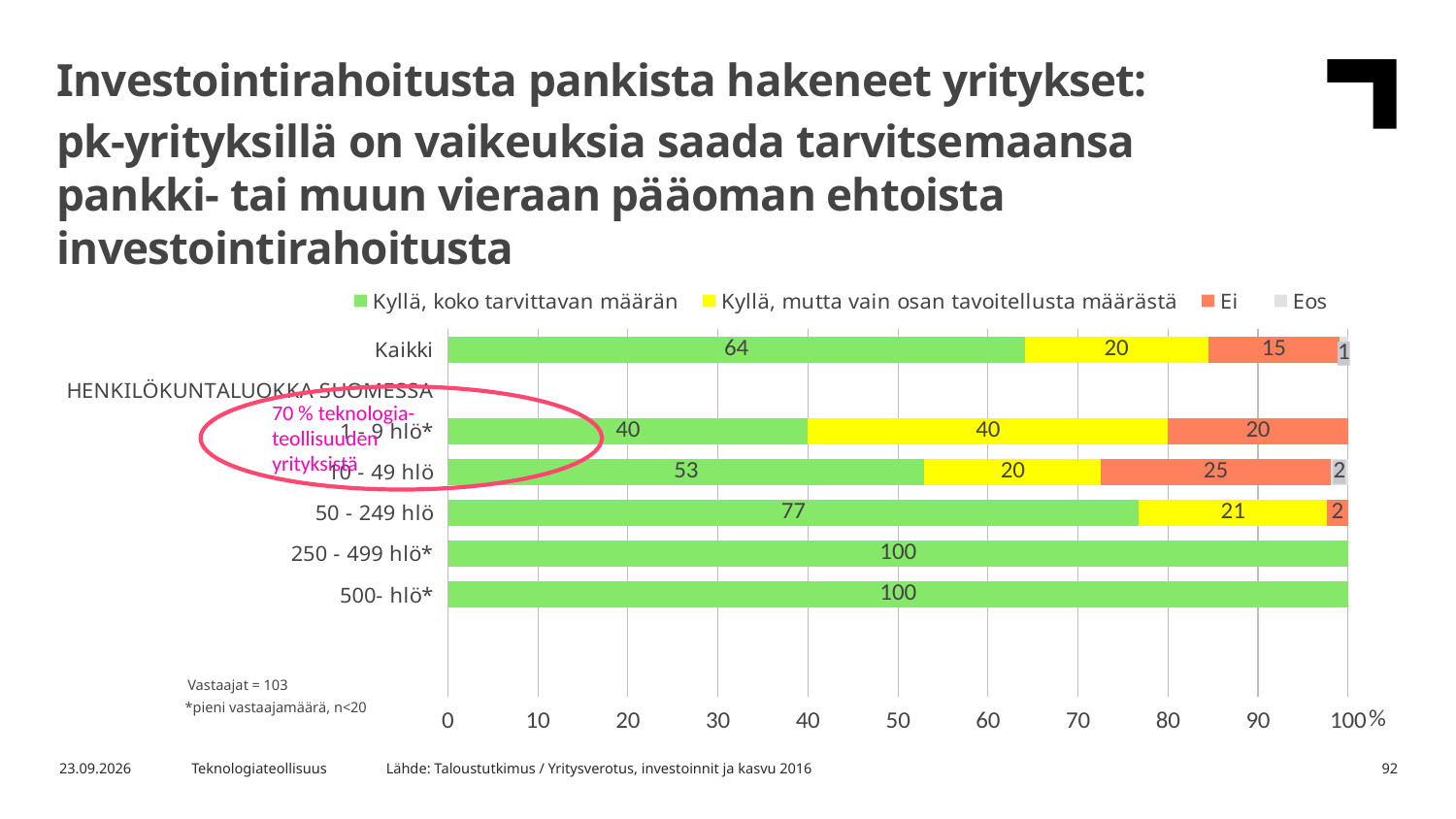
What is the value of 'Kyllä, mutta vain osan tavoitellusta määrästä' for the '1 - 9 hlö*' category? 40 What is the value of 'Ei' for the '10 - 49 hlö' category? 25 What is the value of 'Kyllä, koko tarvittavan määrän' for the '50 - 249 hlö' category? 77 What type of chart is shown on the slide? stacked bar chart Which category has the highest value for 'Ei'? 10 - 49 hlö Which category has the lowest value for 'Kyllä, koko tarvittavan määrän'? 1 - 9 hlö* Which is larger: the 'Ei' value for 'Kaikki' or the 'Ei' value for '1 - 9 hlö*'? 1 - 9 hlö* What is the difference between the 'Kyllä, koko tarvittavan määrän' values for '50 - 249 hlö' and '10 - 49 hlö'? 24 What is the total of the stacked bar for the 'Kaikki' category? 100 What is the value of 'Kyllä, koko tarvittavan määrän' for the 'Kaikki' category? 64 How many series does the legend list? 4